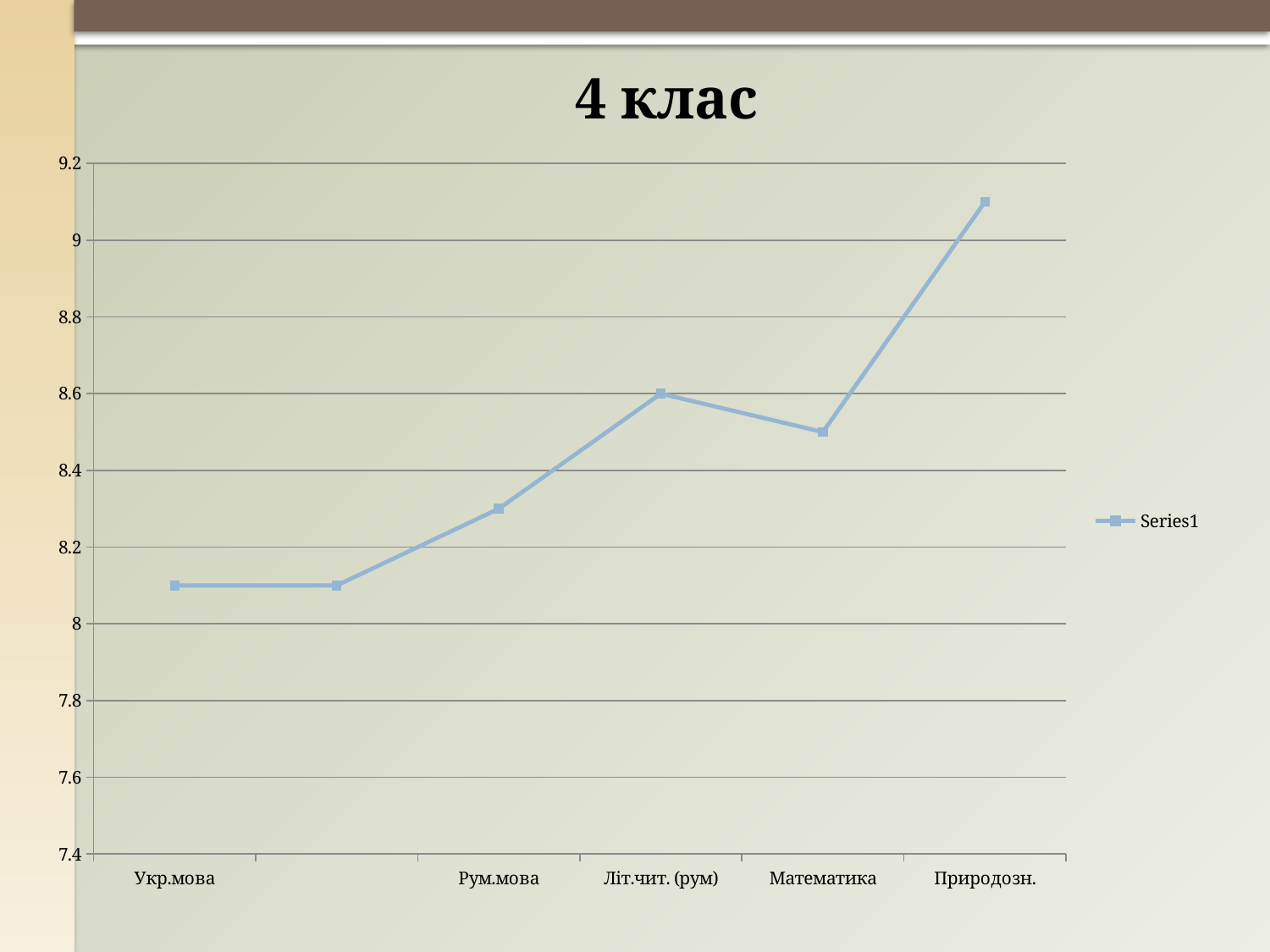
What is the value for Літ.чит. (рум)? 8.6 Which category has the highest value? Природозн. How many series does the legend list? 1 Is the value for Математика greater or less than 8.4? greater Is the value for Природозн. greater or less than 9? greater Is the value for Укр.мова greater or less than 8.2? less Which is larger, the value for Рум.мова or the value for Математика? Математика What is the name of the series shown in the legend? Series1 What kind of chart is shown on the slide? line chart How many data points are plotted on the line? 6 Do the values generally rise or fall from Укр.мова to Природозн.? rise What is the title of the chart? 4 клас